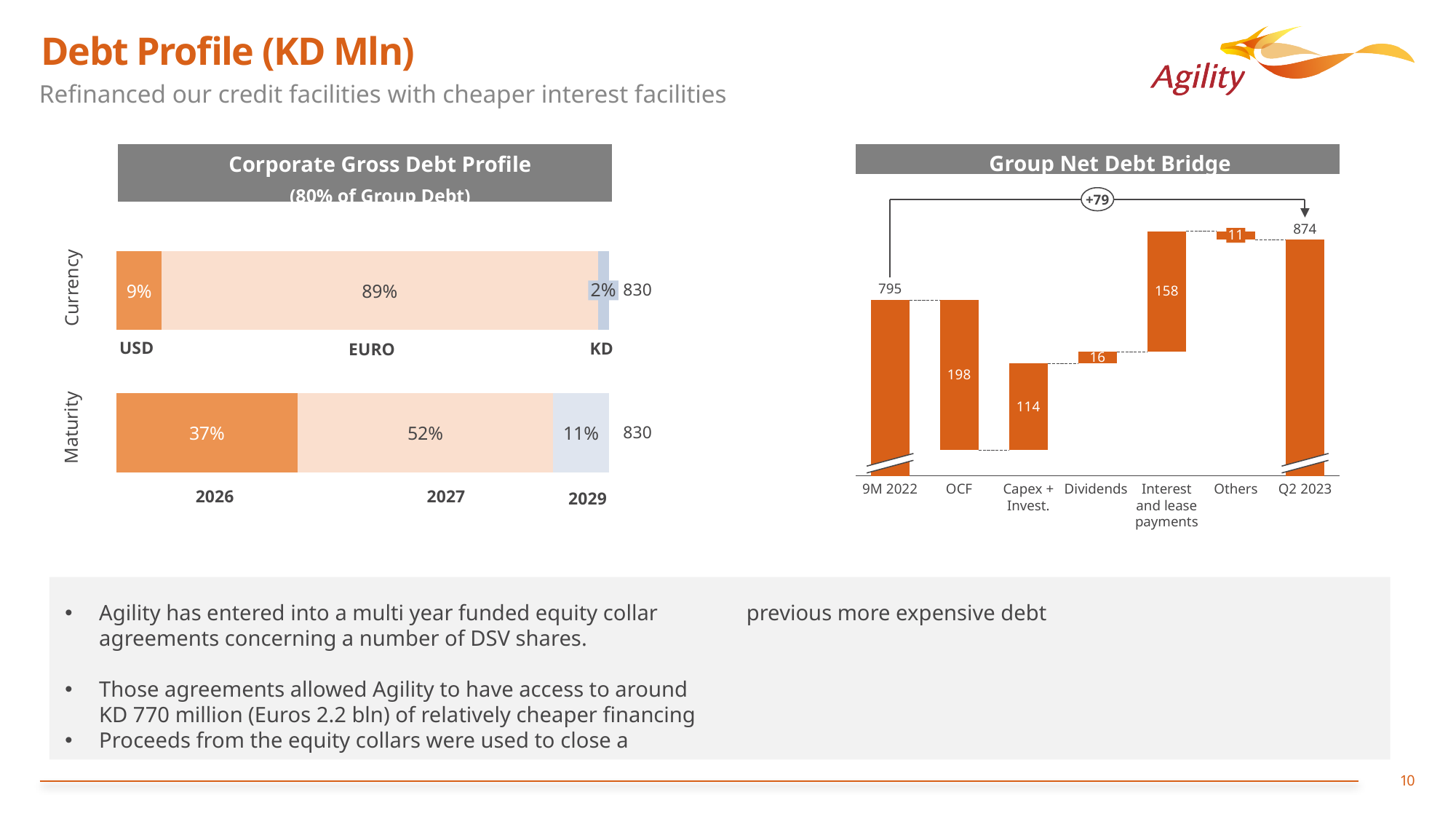
In the Corporate Gross Debt Profile chart, which maturity year has the smallest share? 2029 In the Corporate Gross Debt Profile chart, what total value is printed at the end of the currency bar? 830 In the Corporate Gross Debt Profile chart, what percentage of the currency bar is EURO? 89% In the Group Net Debt Bridge chart, what is the difference between the Q2 2023 value and the 9M 2022 value? 79 How many categories are shown along the x axis of the Group Net Debt Bridge chart? 7 In the Group Net Debt Bridge chart, what is the value for Q2 2023? 874 In the Corporate Gross Debt Profile chart, what percentage of the maturity bar falls in 2027? 52% In the Corporate Gross Debt Profile chart, which currency has the largest share? EURO In the Group Net Debt Bridge chart, what is the value for 9M 2022? 795 In the Group Net Debt Bridge chart, which step has the smallest value? Others In the Group Net Debt Bridge chart, what is the value for OCF? 198 In the Group Net Debt Bridge chart, which is larger: Interest and lease payments or Capex + Invest.? Interest and lease payments